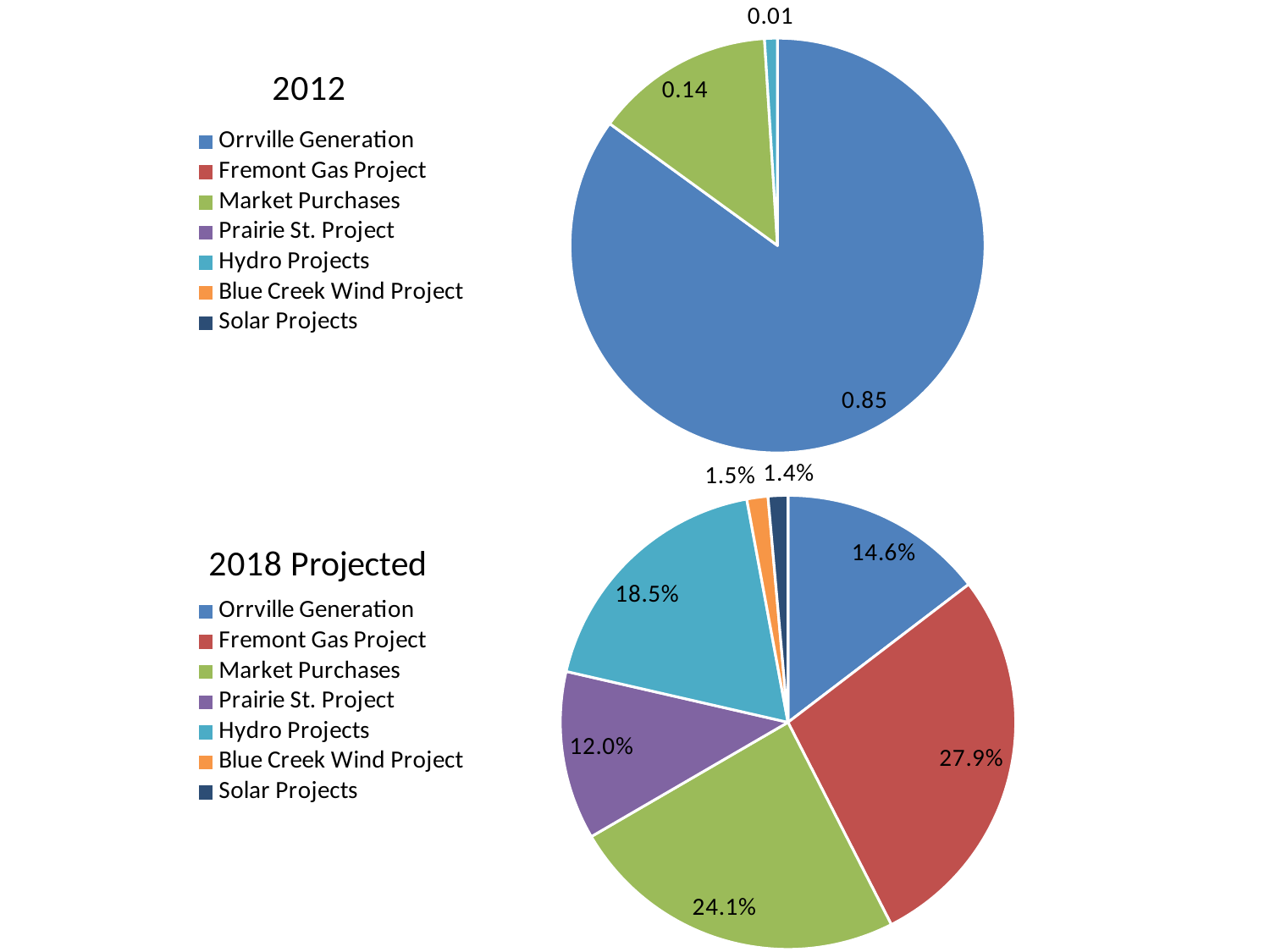
What kind of charts are shown on the slide? Pie charts In the 2018 Projected chart, what is the share for Hydro Projects? 18.5% In the 2018 Projected chart, which category has the largest share? Fremont Gas Project In the 2018 Projected chart, what is the share for Solar Projects? 1.4% In the 2018 Projected chart, which is larger, Market Purchases or Orrville Generation? Market Purchases How many entries does the legend of the 2018 Projected chart list? 7 In the 2018 Projected chart, what is the share for Prairie St. Project? 12.0% In the 2012 chart, what is the value for Market Purchases? 0.14 In the 2018 Projected chart, what is the difference between the Fremont Gas Project share and the Market Purchases share? 3.8% In the 2012 chart, which category has the largest slice? Orrville Generation In the 2018 Projected chart, what is the share for Fremont Gas Project? 27.9% In the 2012 chart, what is the value for Orrville Generation? 0.85